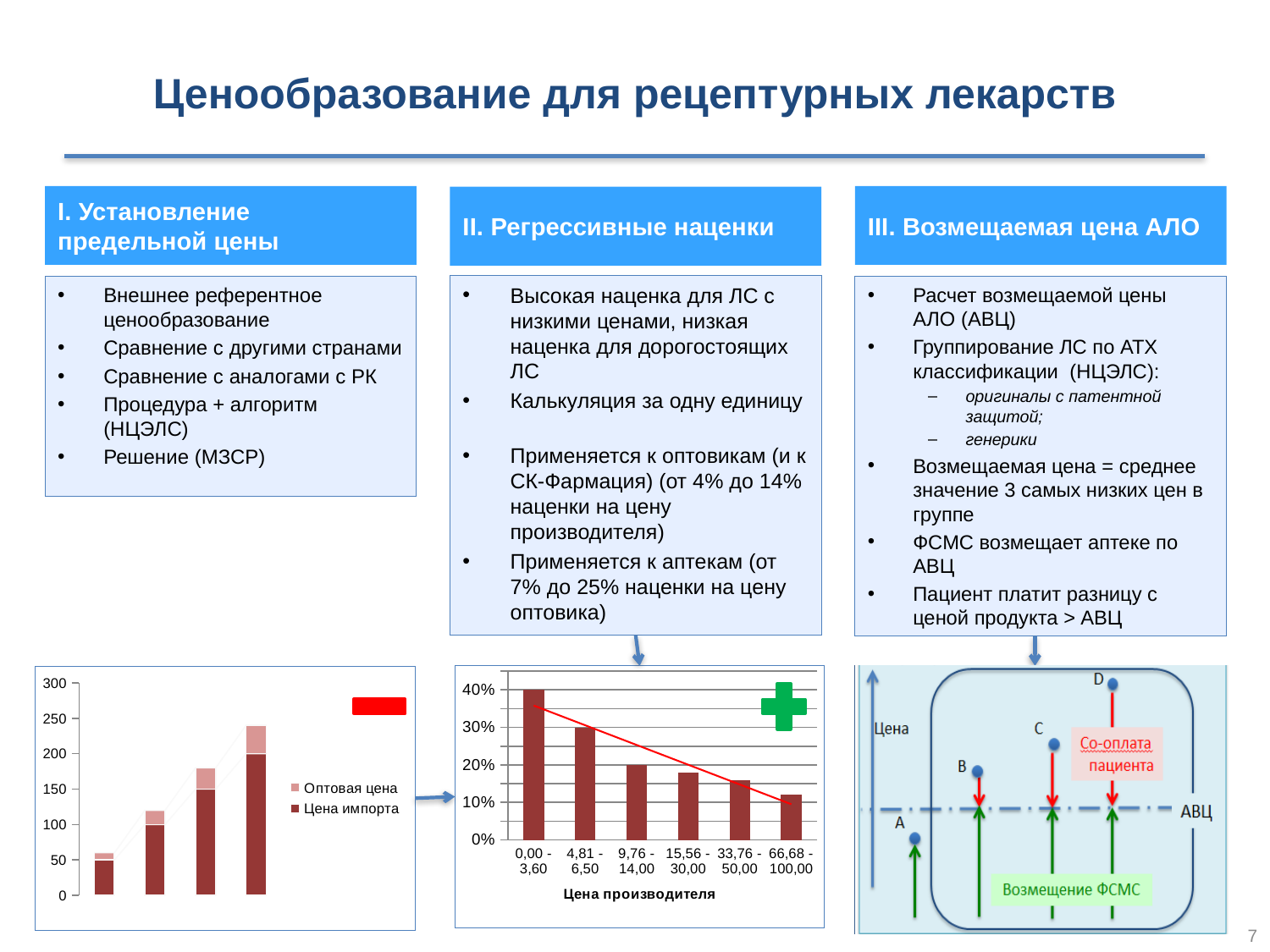
What kind of chart is the middle chart at the bottom of the slide (x axis 'Цена производителя')? bar chart In the middle chart (x axis 'Цена производителя'), which category has the lowest value? 66,68 - 100,00 In the bottom-left stacked bar chart, how many series does the legend list? 2 In the bottom-left stacked bar chart, is the total of the rightmost bar greater or less than 200? greater In the middle chart (x axis 'Цена производителя'), is the value for '4,81 - 6,50' greater or less than 20%? greater In the middle chart (x axis 'Цена производителя'), which category has the highest value? 0,00 - 3,60 In the middle chart (x axis 'Цена производителя'), is the value for '66,68 - 100,00' greater or less than 20%? less In the middle chart (x axis 'Цена производителя'), what is the value for the category '0,00 - 3,60'? 40% In the middle chart (x axis 'Цена производителя'), which is larger: the value for '9,76 - 14,00' or the value for '33,76 - 50,00'? 9,76 - 14,00 In the middle chart (x axis 'Цена производителя'), do the values rise or fall as the producer price increases along the x axis? fall In the middle chart (x axis 'Цена производителя'), how many price categories are shown on the x axis? 6 In the bottom-left stacked bar chart, what are the two legend entries? Оптовая цена, Цена импорта